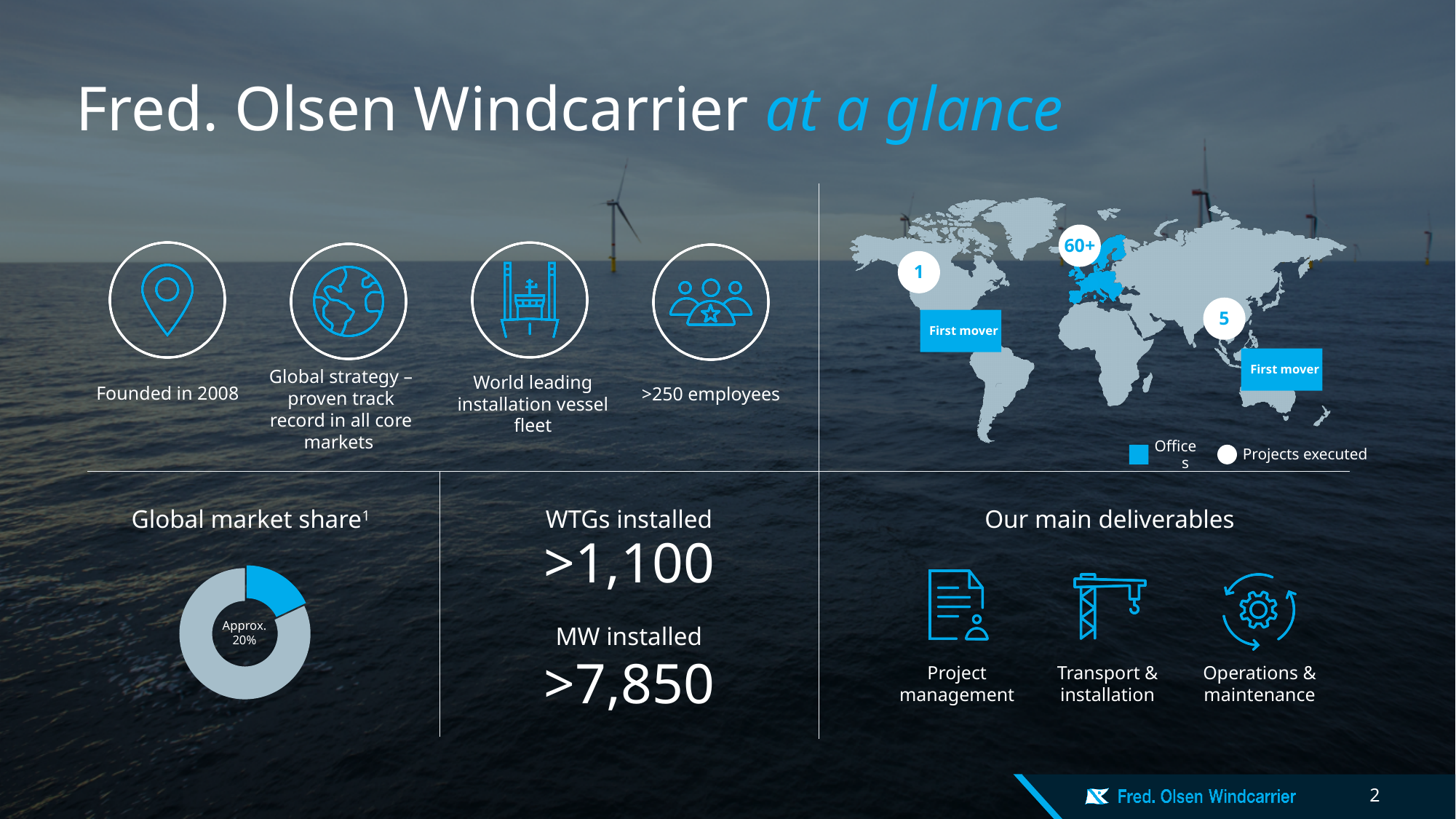
What colour is the slice representing the company's share in the Global market share chart? Blue What label is printed in the centre of the Global market share chart? Approx. 20% What is the title of the chart in the lower-left section of the slide? Global market share What kind of chart is shown under the heading "Global market share"? Pie chart (donut) How many slices does the Global market share chart have? 2 In the Global market share chart, is the blue slice greater or less than 50% of the chart? less In the Global market share chart, which slice is larger, the blue slice or the grey slice? The grey slice